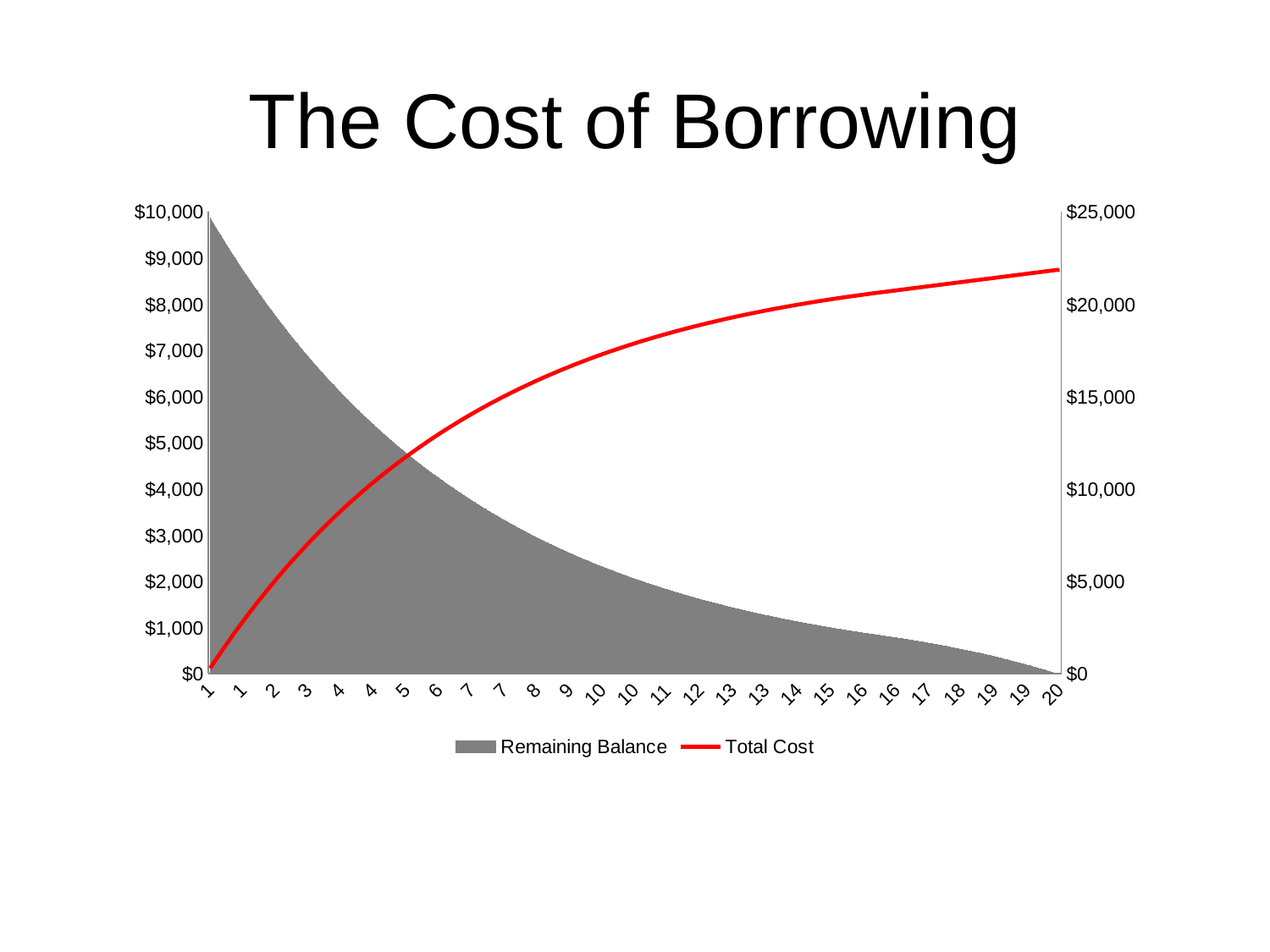
Is the Total Cost at point 10 greater or less than $15,000? greater What is the title of the chart? The Cost of Borrowing How many series does the legend list? 2 What kind of chart is shown on the slide? A combination area and line chart Is the Total Cost at point 5 greater or less than $10,000? greater Is the Total Cost at the final point (20) greater or less than $20,000? greater Does the Remaining Balance rise or fall along the x axis? Fall Which series is drawn as a red line? Total Cost Does the Total Cost rise or fall along the x axis? Rise